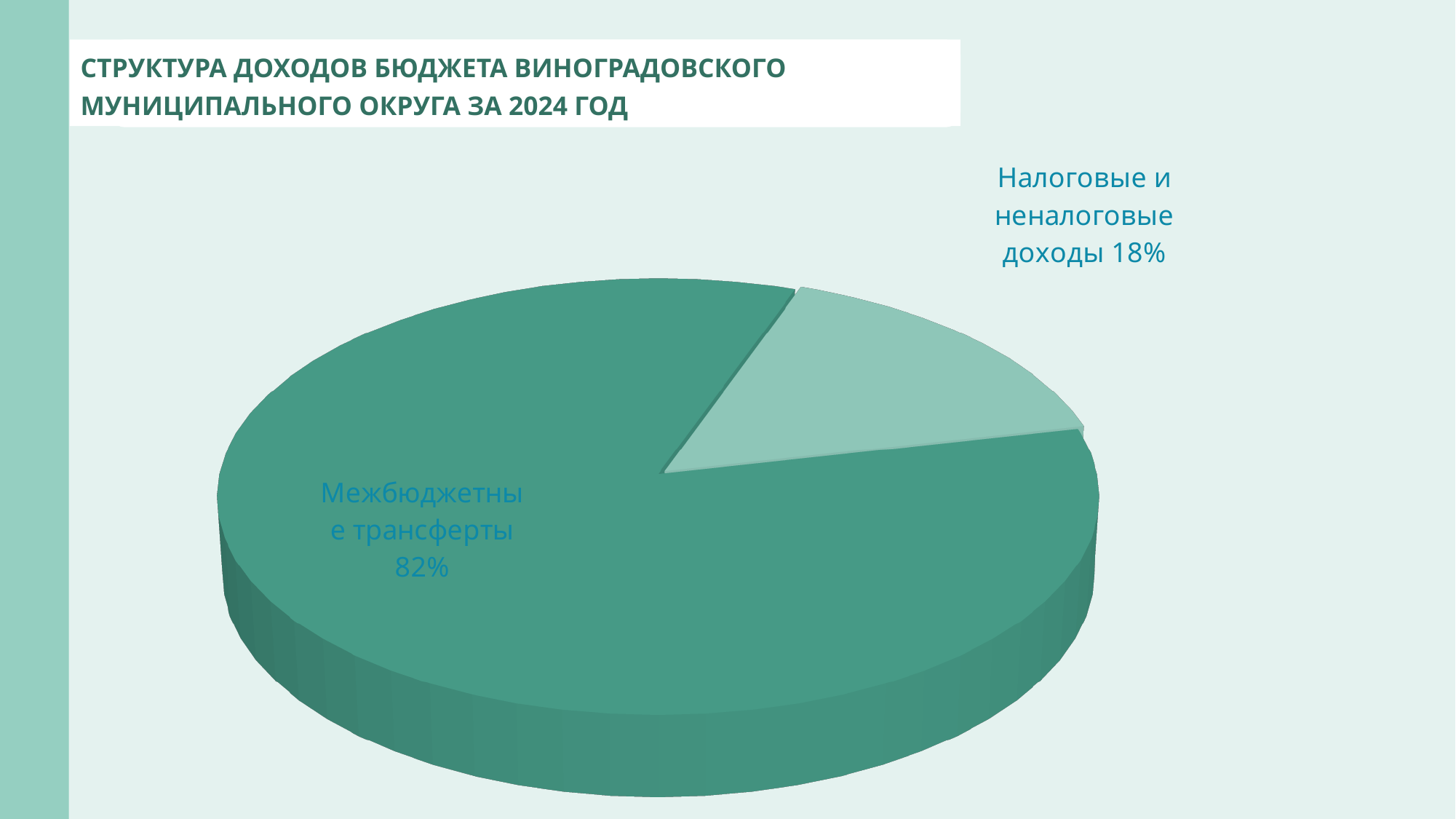
What kind of chart is shown on the slide? Pie chart How many slices does the pie chart have? 2 Which slice of the pie is the smallest? Налоговые и неналоговые доходы Which slice of the pie is the largest? Межбюджетные трансферты Which year does the chart cover? 2024 What is the difference in percentage points between Межбюджетные трансферты and Налоговые и неналоговые доходы? 64 What share of the pie does Межбюджетные трансферты represent? 82% Which is larger: Межбюджетные трансферты or Налоговые и неналоговые доходы? Межбюджетные трансферты What is the title of the slide? СТРУКТУРА ДОХОДОВ БЮДЖЕТА ВИНОГРАДОВСКОГО МУНИЦИПАЛЬНОГО ОКРУГА ЗА 2024 ГОД What share of the pie does Налоговые и неналоговые доходы represent? 18%